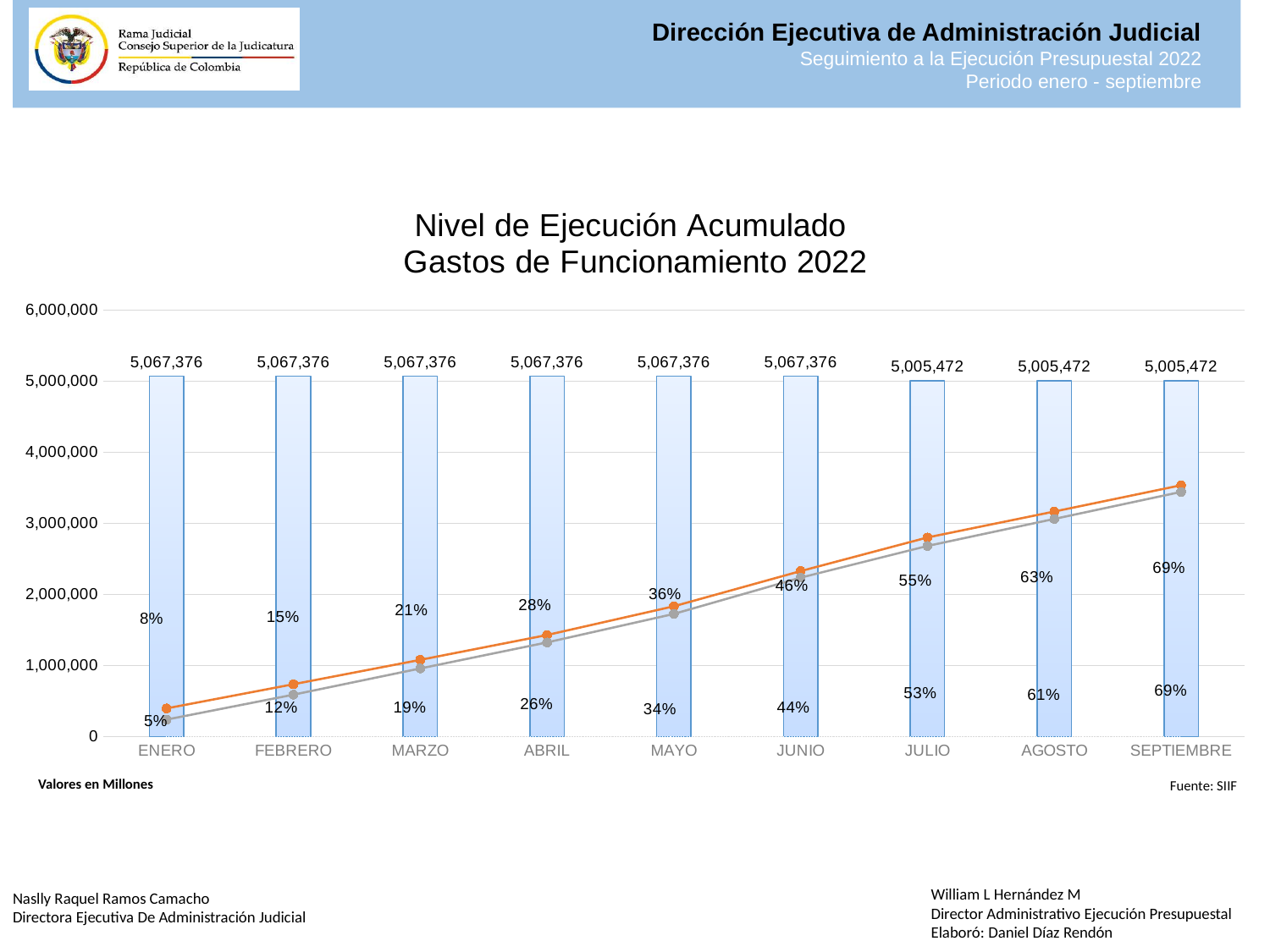
What is the title of the chart? Nivel de Ejecución Acumulado Gastos de Funcionamiento 2022 What is the bar value labelled for ENERO? 5,067,376 What is the difference between the bar value for JUNIO and the bar value for JULIO? 61,904 What is the lower percentage label shown for ENERO? 5% Do the plotted lines rise or fall from ENERO to SEPTIEMBRE? rise Is the value of the orange line at ENERO greater or less than 1,000,000? less How many months are shown on the x axis? 9 What is the bar value labelled for JULIO? 5,005,472 What is the higher percentage label shown for JUNIO? 46% What is the bar value labelled for SEPTIEMBRE? 5,005,472 Which is larger, the bar value for MAYO or the bar value for AGOSTO? MAYO Is the value of the orange line at SEPTIEMBRE greater or less than 3,000,000? greater